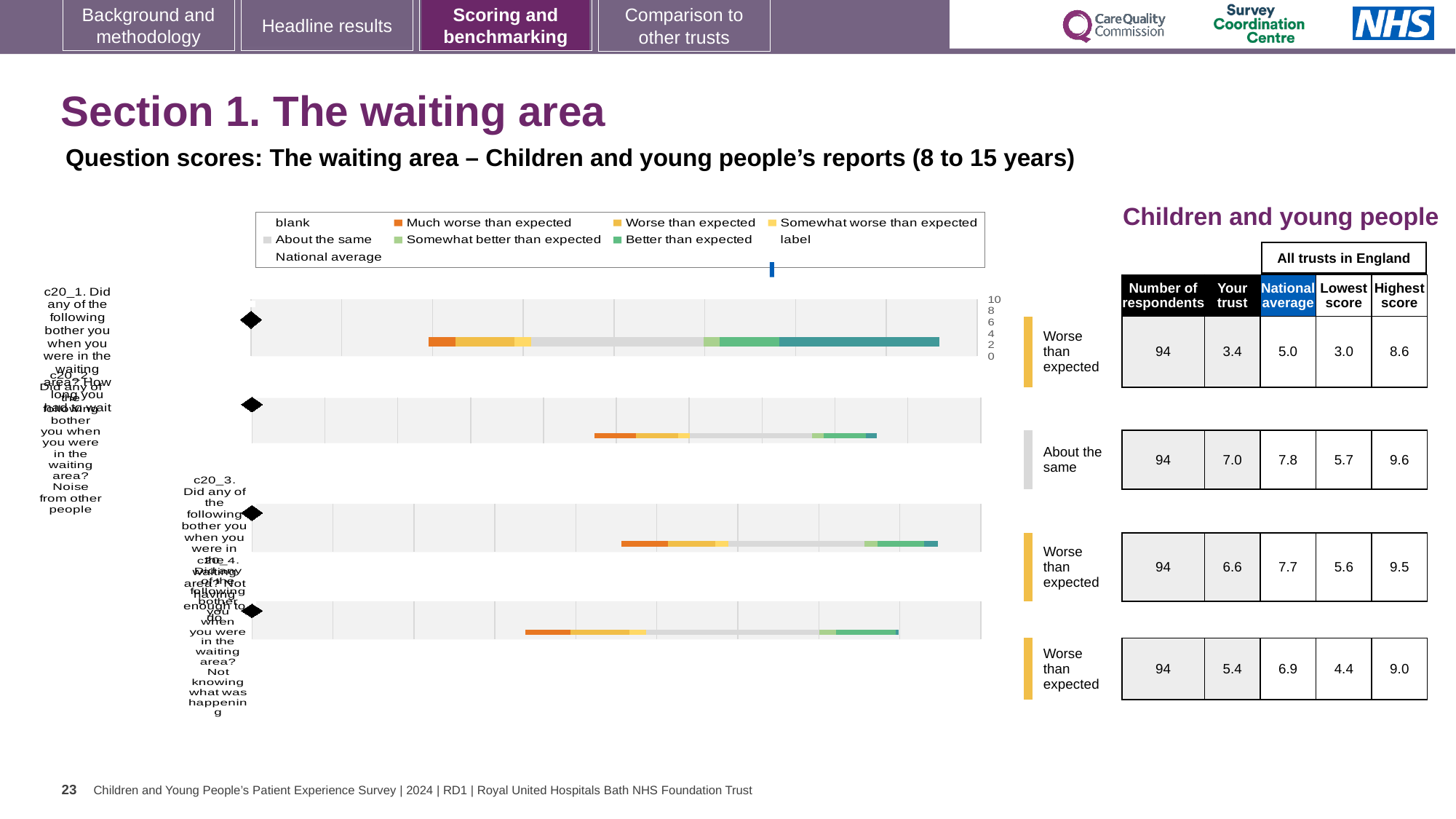
In the table to the right of the chart, what is the difference between the National average and Your trust score in the first row? 1.6 In the table to the right of the chart, which row has the highest 'Your trust' score? About the same In the table to the right of the chart, how many respondents are listed for each row? 94 What is the maximum value shown on the chart's axis? 10 How many horizontal bars are plotted in the chart? 4 How many entries does the chart legend list? 9 What colour does the legend use for 'Much worse than expected'? orange In the table to the right of the chart, what is the National average for the 'About the same' row? 7.8 In the table to the right of the chart, what is the 'Your trust' score for the first row (Worse than expected)? 3.4 What kind of chart is shown on the slide? bar chart In the table to the right of the chart, what is the Highest score in the last row? 9.0 In the table to the right of the chart, is the Your trust score in the third row (6.6) larger or smaller than the National average (7.7)? smaller